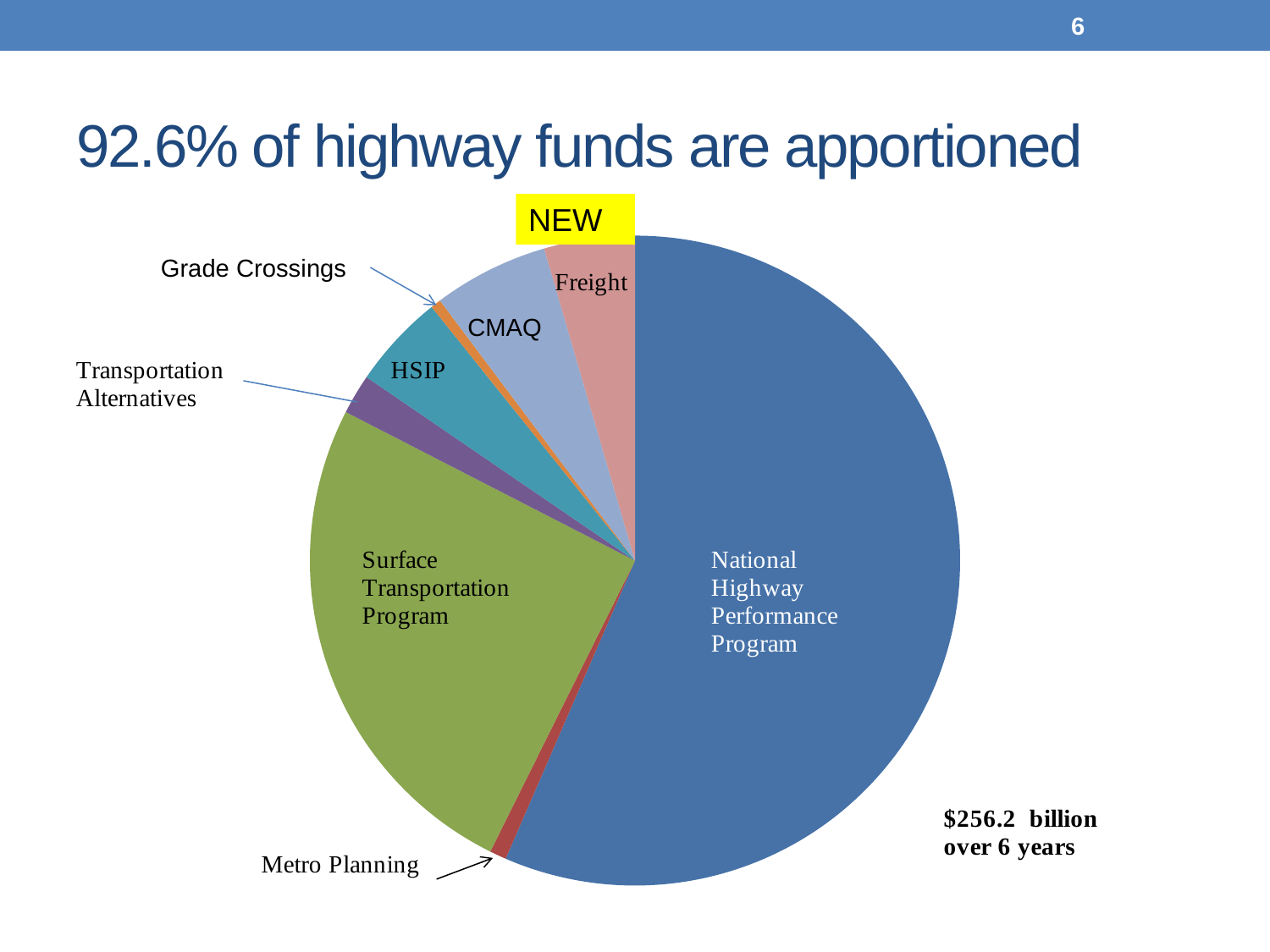
Which program has the largest slice of the pie chart? National Highway Performance Program Which is larger, the HSIP slice or the Metro Planning slice? HSIP Which is larger, the Surface Transportation Program slice or the CMAQ slice? Surface Transportation Program Which is larger, the National Highway Performance Program slice or the Surface Transportation Program slice? National Highway Performance Program What kind of chart is shown on the slide? pie chart What total funding amount is noted next to the pie chart? $256.2 billion over 6 years Which slice of the pie chart is marked as NEW? Freight Is the National Highway Performance Program's share of the pie greater or less than half? greater How many slices does the pie chart have? 8